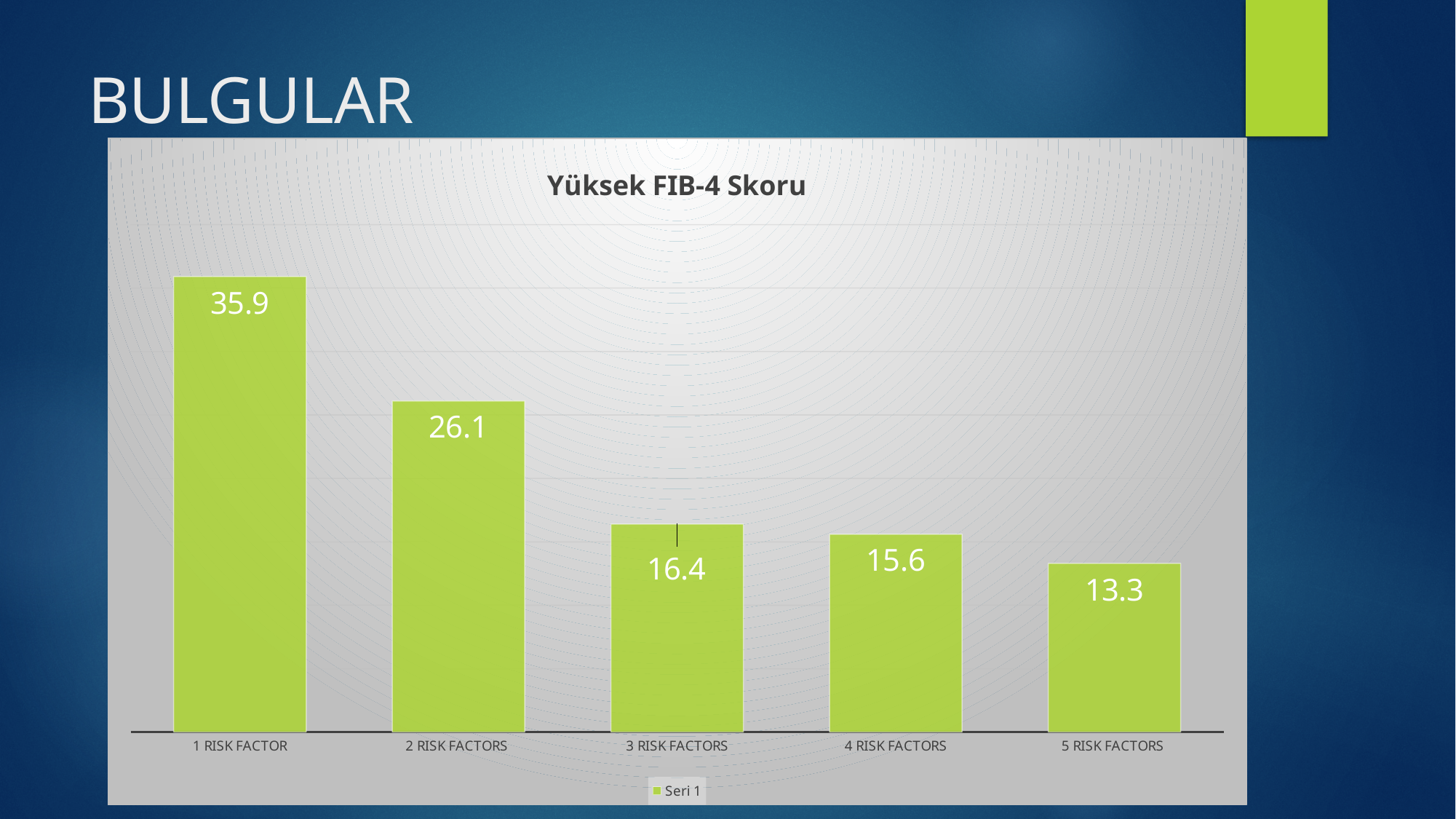
Which is larger, the value for 2 RISK FACTORS or the value for 4 RISK FACTORS? 2 RISK FACTORS What is the value for 1 RISK FACTOR? 35.9 Do the values rise or fall from 1 RISK FACTOR to 5 RISK FACTORS? fall What kind of chart is shown on the slide? bar chart What is the value for 3 RISK FACTORS? 16.4 What is the difference between the values for 1 RISK FACTOR and 2 RISK FACTORS? 9.8 Which category has the highest value? 1 RISK FACTOR What is the difference between the values for 4 RISK FACTORS and 5 RISK FACTORS? 2.3 Which category has the lowest value? 5 RISK FACTORS How many categories are shown on the x axis? 5 How many series does the legend list? 1 What is the value for 5 RISK FACTORS? 13.3